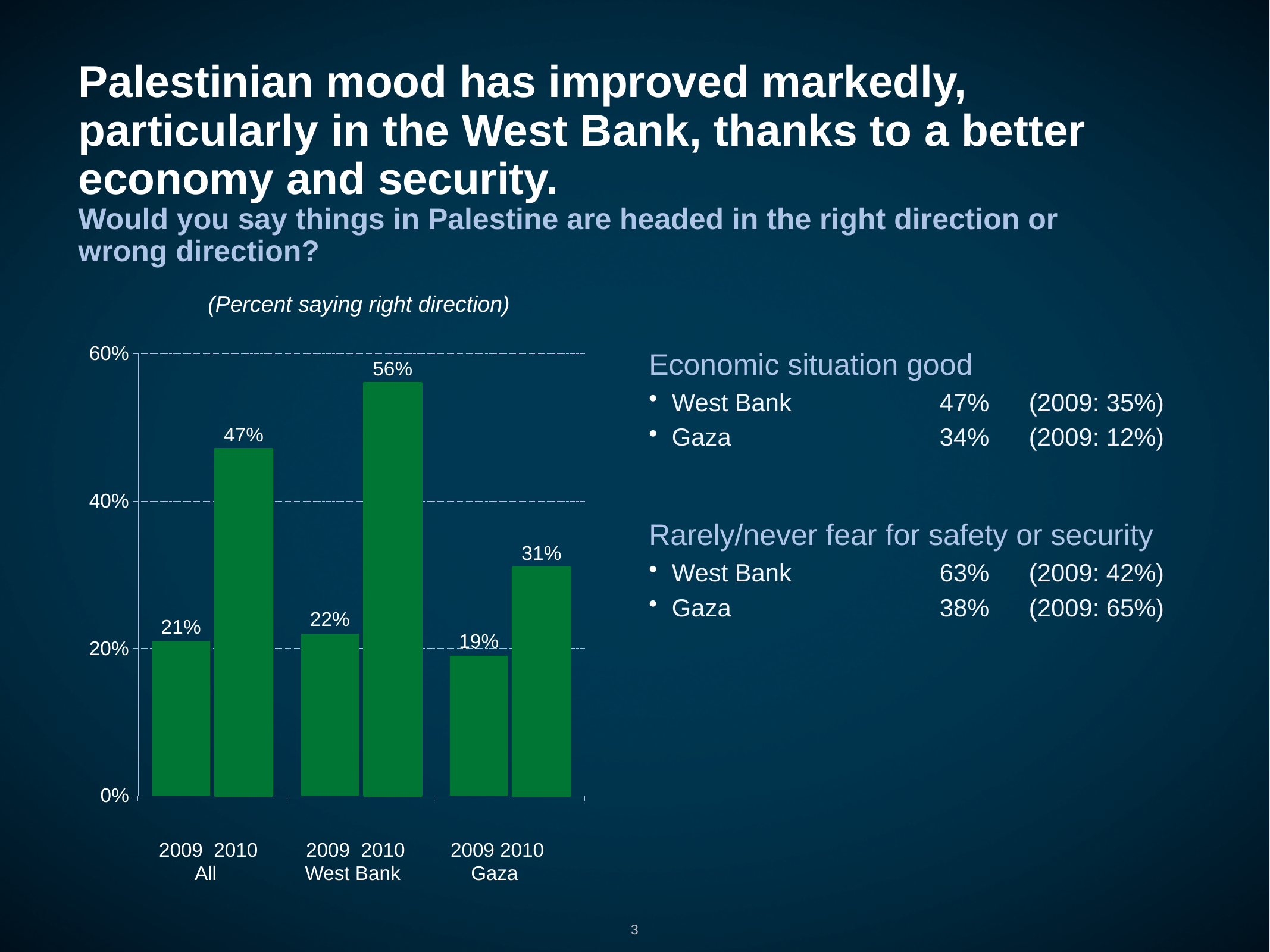
By how many percentage points did the West Bank value rise from 2009 to 2010? 34 Is the 2010 value for the West Bank greater or less than 40%? greater Which is larger, the 2010 value for All or the 2010 value for Gaza? All 2010 What percent of all Palestinians said things were headed in the right direction in 2010? 47% What does the chart's subtitle say the bars represent? Percent saying right direction What was the 2010 value for Gaza in the chart? 31% What is the difference between the 2010 values for the West Bank and Gaza? 25 Which bar in the chart has the highest value? West Bank 2010 Which bar in the chart has the lowest value? Gaza 2009 What kind of chart is shown on the slide? bar chart What was the 2009 value for the West Bank in the chart? 22% How many bars are plotted in the chart? 6